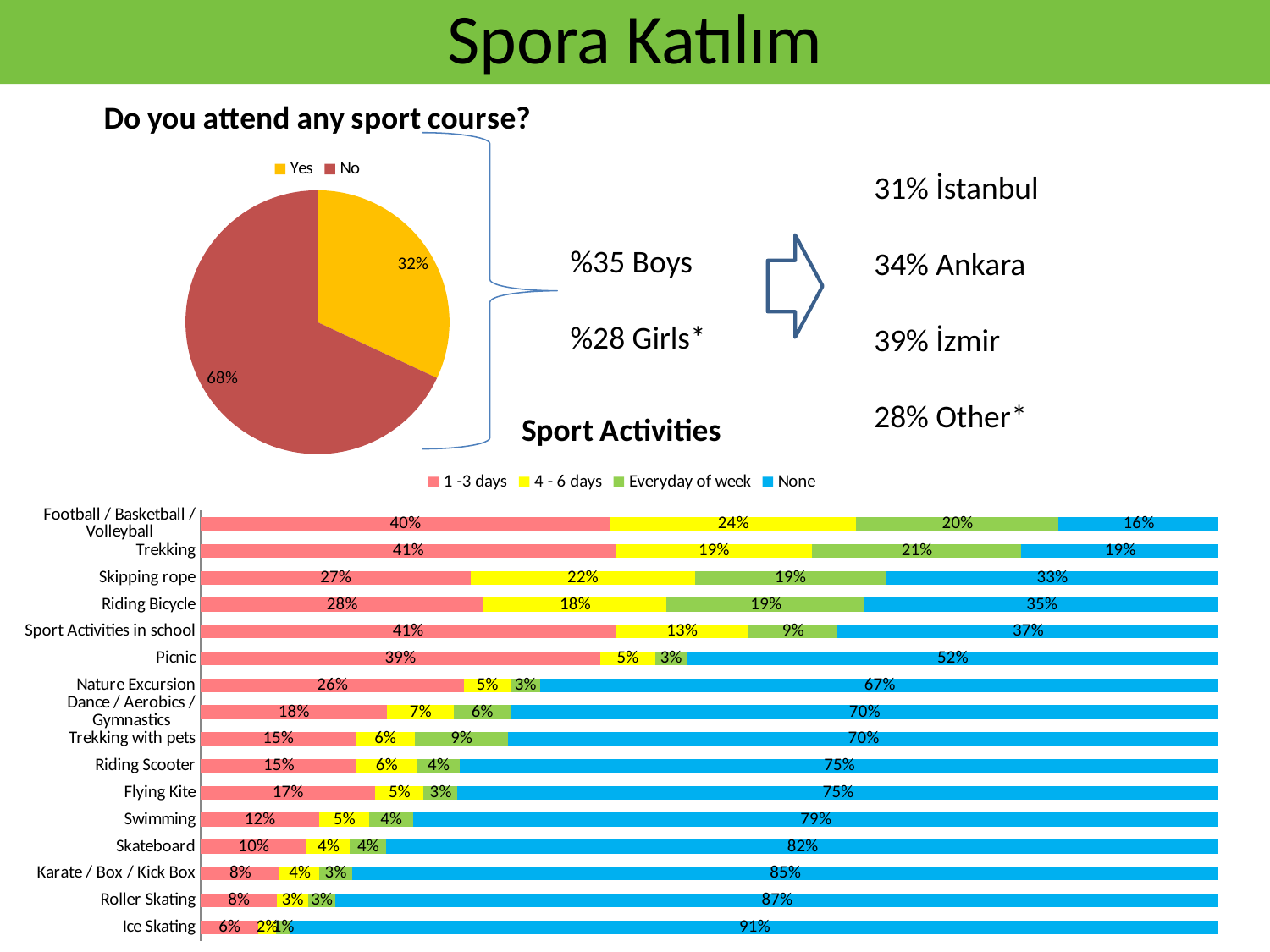
What kind of chart is the 'Sport Activities' chart? Bar chart In the pie chart 'Do you attend any sport course?', what share of respondents answered Yes? 32% In the 'Sport Activities' chart, how many activity categories are shown? 16 In the 'Sport Activities' chart, how many series does the legend list? 4 In the 'Sport Activities' chart, which is larger: the 'Everyday of week' value for Trekking or for Riding Bicycle? Trekking In the pie chart 'Do you attend any sport course?', which answer has the larger slice? No In the 'Sport Activities' chart, what is the '1 -3 days' value for Trekking? 41% In the 'Sport Activities' chart, what is the difference between the 'None' values for Swimming and Skateboard? 3% In the pie chart 'Do you attend any sport course?', what share of respondents answered No? 68% In the 'Sport Activities' chart, what is the 'None' value for Ice Skating? 91% In the pie chart 'Do you attend any sport course?', how many entries does the legend list? 2 In the 'Sport Activities' chart, which activity has the highest 'None' value? Ice Skating